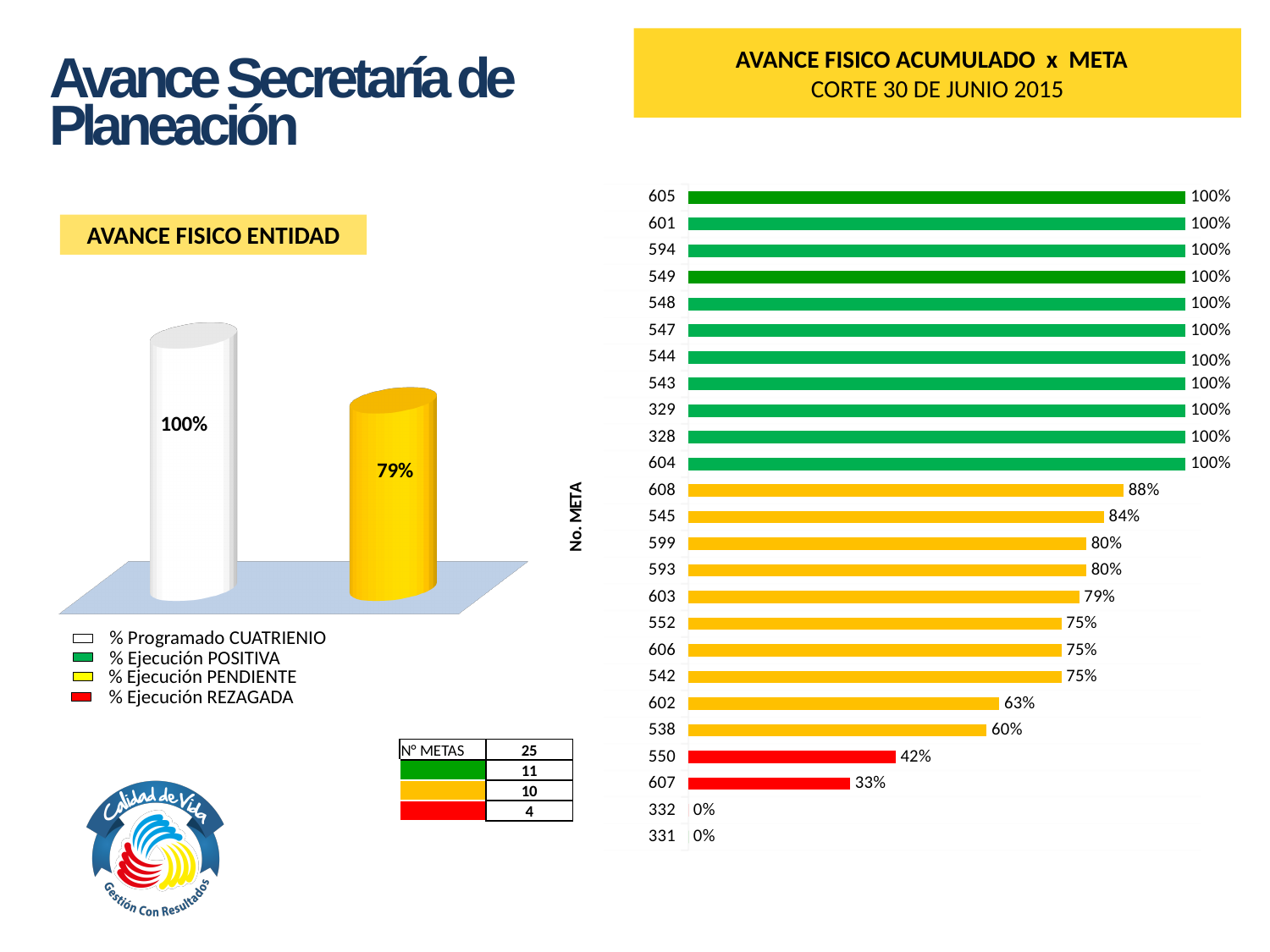
In the AVANCE FISICO ACUMULADO x META chart, what is the value for meta 602? 63% In the AVANCE FISICO ACUMULADO x META chart, what is the value for meta 550? 42% In the AVANCE FISICO ACUMULADO x META chart, which is larger, the value for meta 538 or the value for meta 603? 603 In the AVANCE FISICO ACUMULADO x META chart, what is the difference between the values for meta 545 and meta 607? 51% In the AVANCE FISICO ENTIDAD chart, what is the value of the yellow bar? 79% In the AVANCE FISICO ACUMULADO x META chart, what is the value for meta 608? 88% In the AVANCE FISICO ENTIDAD chart, what is the value of the % Programado CUATRIENIO bar? 100% How many entries does the legend of the AVANCE FISICO ENTIDAD chart list? 4 In the AVANCE FISICO ACUMULADO x META chart, what is the value for meta 331? 0% In the AVANCE FISICO ENTIDAD chart, what is the difference between the two bars? 21% What kind of chart is the AVANCE FISICO ACUMULADO x META chart? bar chart In the AVANCE FISICO ACUMULADO x META chart, how many metas are listed on the axis? 25